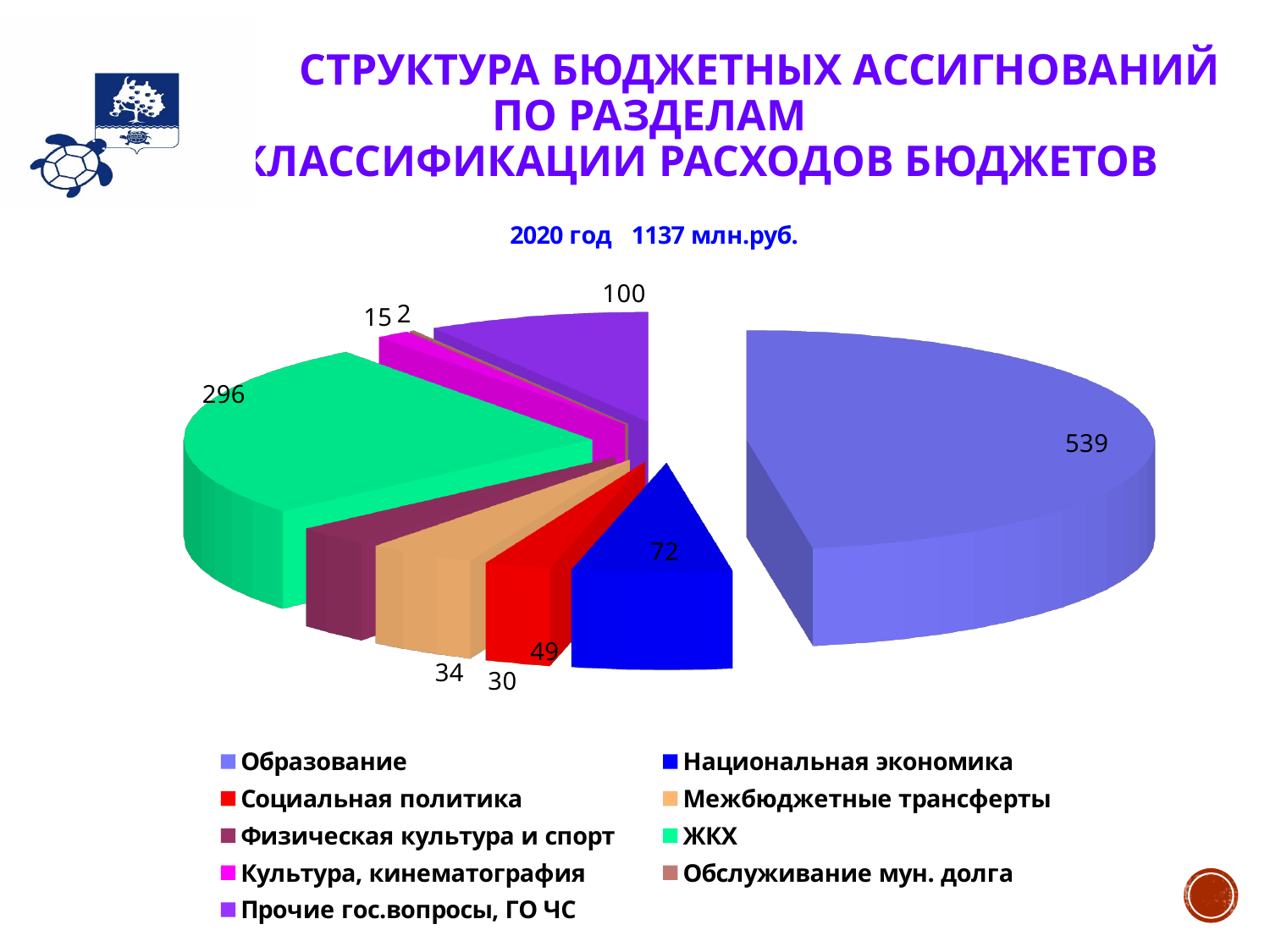
What is the value for ЖКХ? 296 Which category has the smallest slice? Обслуживание мун. долга Which category has the largest slice? Образование What is the value for Социальная политика? 30 Which is larger, Национальная экономика or Социальная политика? Национальная экономика What is the difference between the values for Образование and ЖКХ? 243 What is the value for Культура, кинематография? 15 What is the value for Национальная экономика? 72 What is the value for Прочие гос.вопросы, ГО ЧС? 100 How many categories does the legend list? 9 What type of chart is shown on the slide? pie chart What is the value for Образование? 539